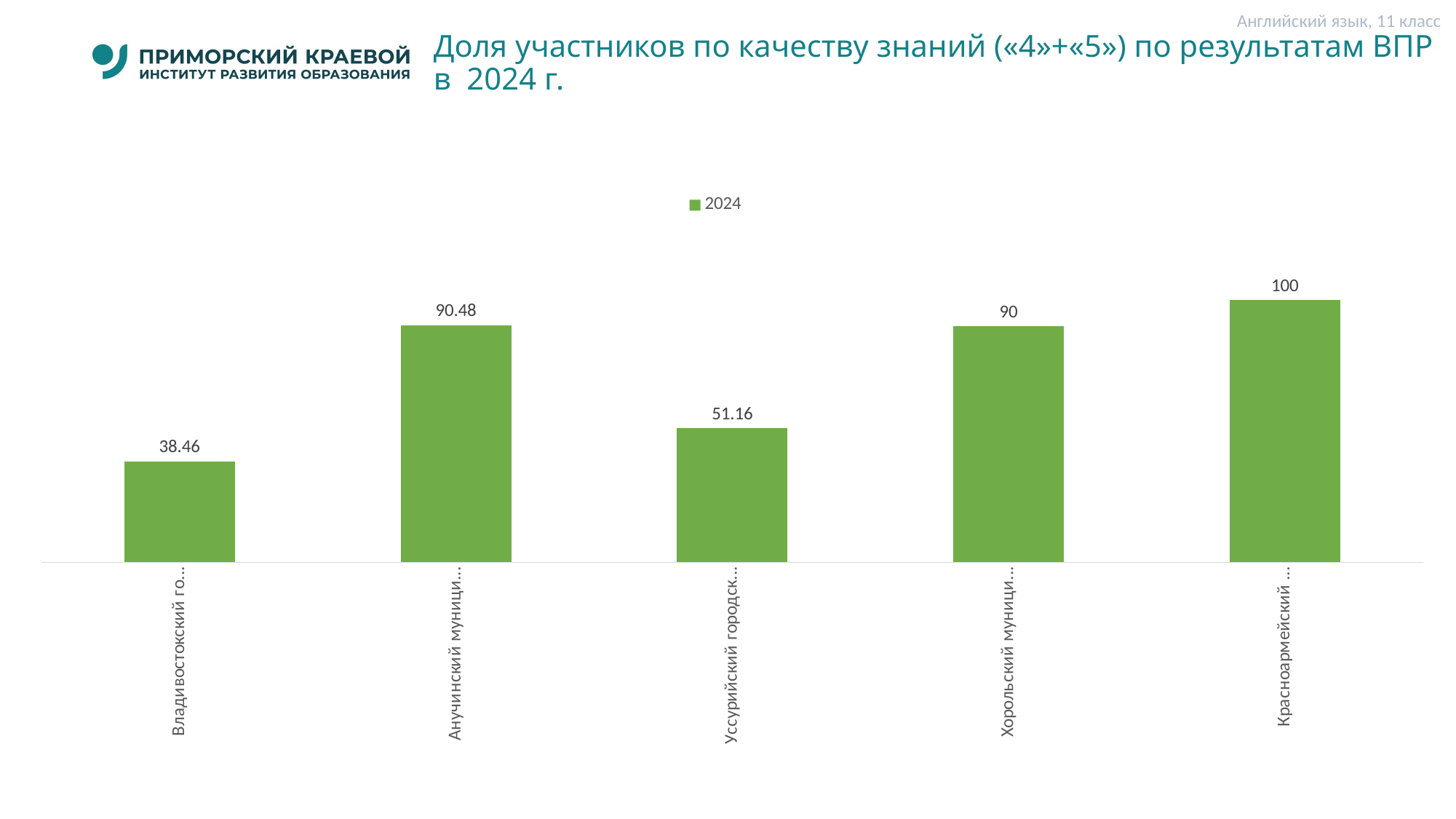
What is the value for Хорольский муници...? 90 What is the value for Владивостокский го...? 38.46 Which is larger, the value for Уссурийский городск... or the value for Хорольский муници...? Хорольский муници... What is the value for Уссурийский городск...? 51.16 What is the value for Красноармейский ...? 100 How many categories are shown in the chart? 5 Which category has the highest value? Красноармейский ... What kind of chart is shown on the slide? Bar chart Which category has the lowest value? Владивостокский го... What is the value for Анучинский муници...? 90.48 How many series does the legend list? 1 What is the difference between the values for Красноармейский ... and Владивостокский го...? 61.54